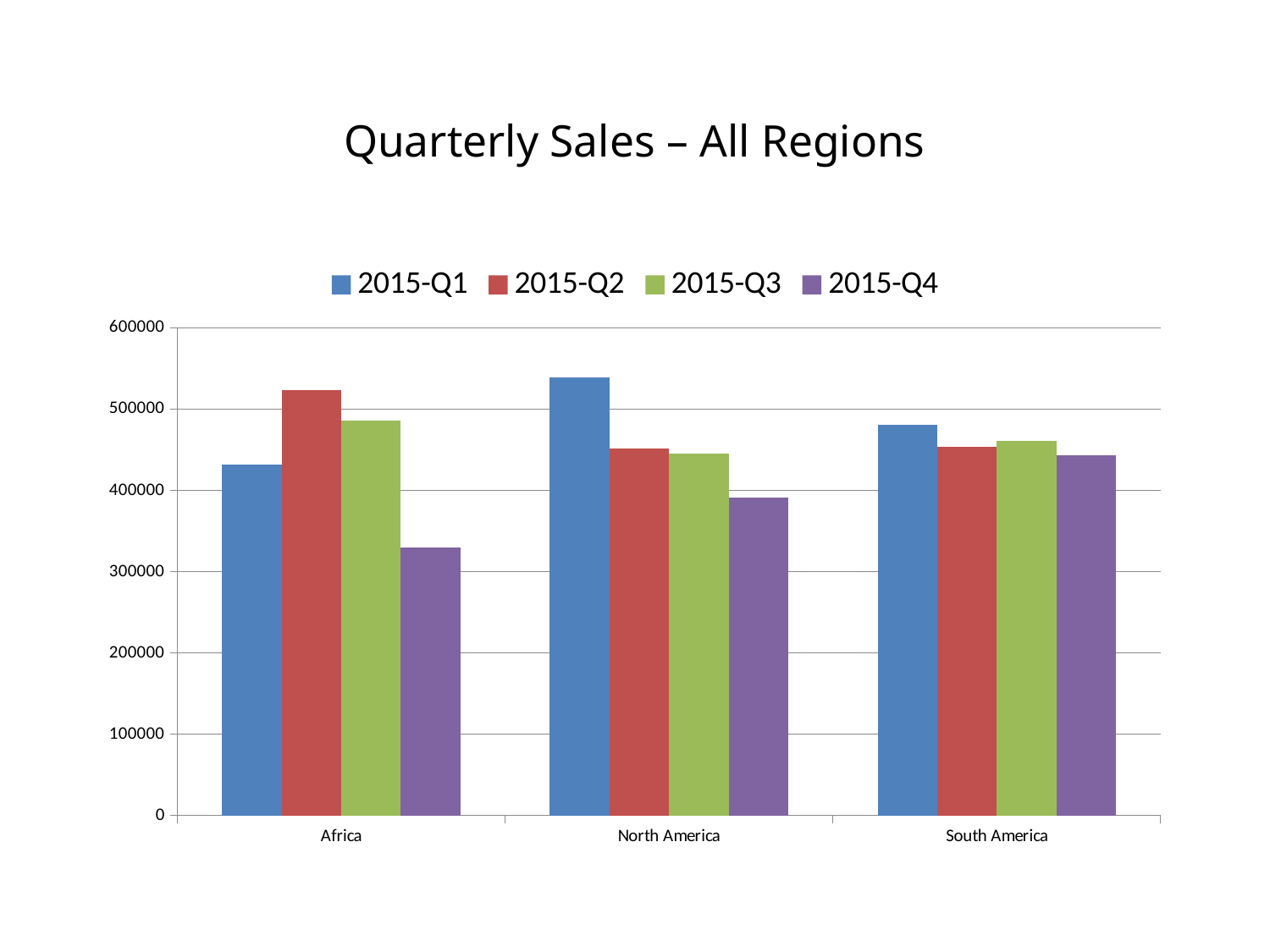
Which is larger, the 2015-Q4 value for Africa or the 2015-Q4 value for North America? North America How many series does the legend list? 4 Which quarter has the highest value for Africa? 2015-Q2 How many regions are shown on the x axis? 3 Is the value for North America in 2015-Q1 greater or less than 500000? greater Do the values for North America rise or fall from 2015-Q1 to 2015-Q4? fall Which quarter has the lowest value for Africa? 2015-Q4 Which quarter has the highest value for North America? 2015-Q1 Is the value for Africa in 2015-Q4 greater or less than 400000? less Which quarter has the lowest value for North America? 2015-Q4 What kind of chart is shown on the slide? bar chart What is the title of the chart? Quarterly Sales – All Regions